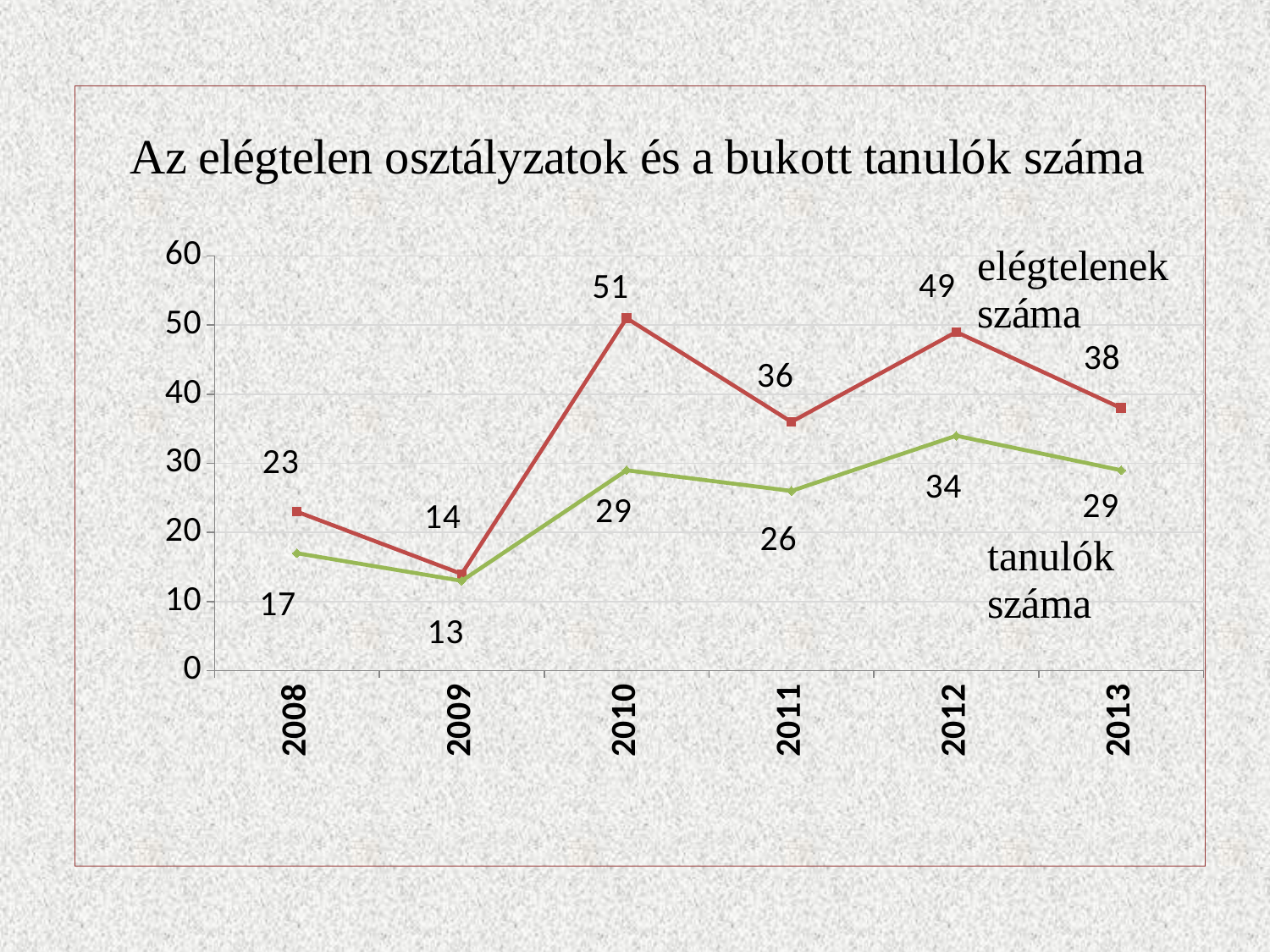
How many years are shown on the x axis? 6 What is the value of 'elégtelenek száma' in 2010? 51 What is the value of 'tanulók száma' in 2009? 13 What is the value of 'elégtelenek száma' in 2013? 38 Which is larger in 2012: 'elégtelenek száma' or 'tanulók száma'? elégtelenek száma In which year is 'tanulók száma' lowest? 2009 How many data series are plotted on the chart? 2 What is the difference between 'elégtelenek száma' and 'tanulók száma' in 2010? 22 Does 'elégtelenek száma' rise or fall from 2012 to 2013? fall What type of chart is shown on the slide? line chart In which year is 'elégtelenek száma' highest? 2010 What is the title of the chart? Az elégtelen osztályzatok és a bukott tanulók száma